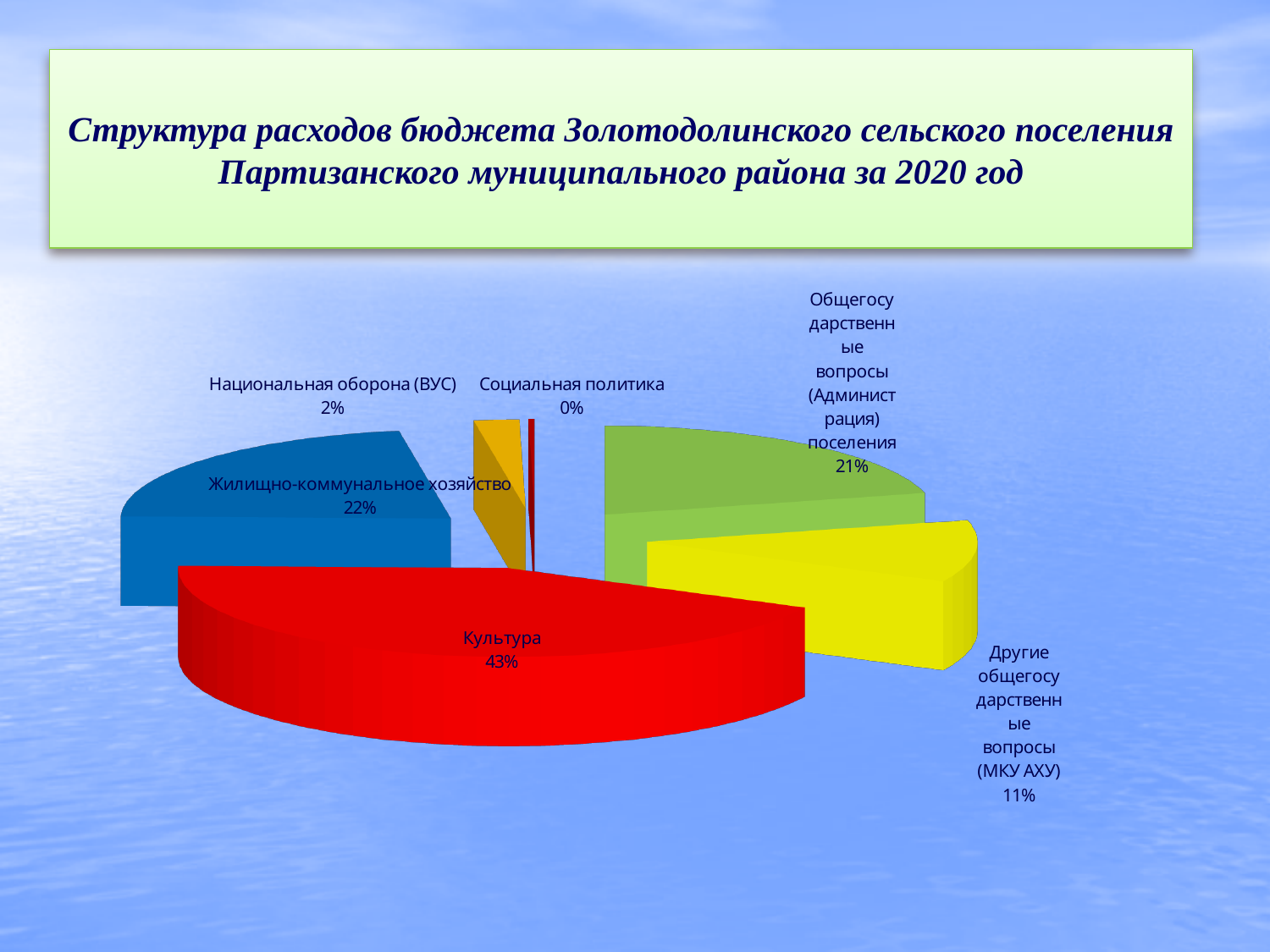
How many categories (slices) does the pie chart show? 6 What share is shown for Общегосударственные вопросы (Администрация) поселения? 21% Which category has the smallest share of the pie? Социальная политика What share is shown for Национальная оборона (ВУС)? 2% What share is shown for Другие общегосударственные вопросы (МКУ АХУ)? 11% What kind of chart is shown on the slide? pie chart Which category has the largest share of the pie? Культура What is the difference in percentage points between Культура and Жилищно-коммунальное хозяйство? 21 What share of the budget expenditure goes to Культура? 43% What share of the budget expenditure goes to Жилищно-коммунальное хозяйство? 22% Which is larger: the share for Жилищно-коммунальное хозяйство or the share for Другие общегосударственные вопросы (МКУ АХУ)? Жилищно-коммунальное хозяйство What share is shown for Социальная политика? 0%